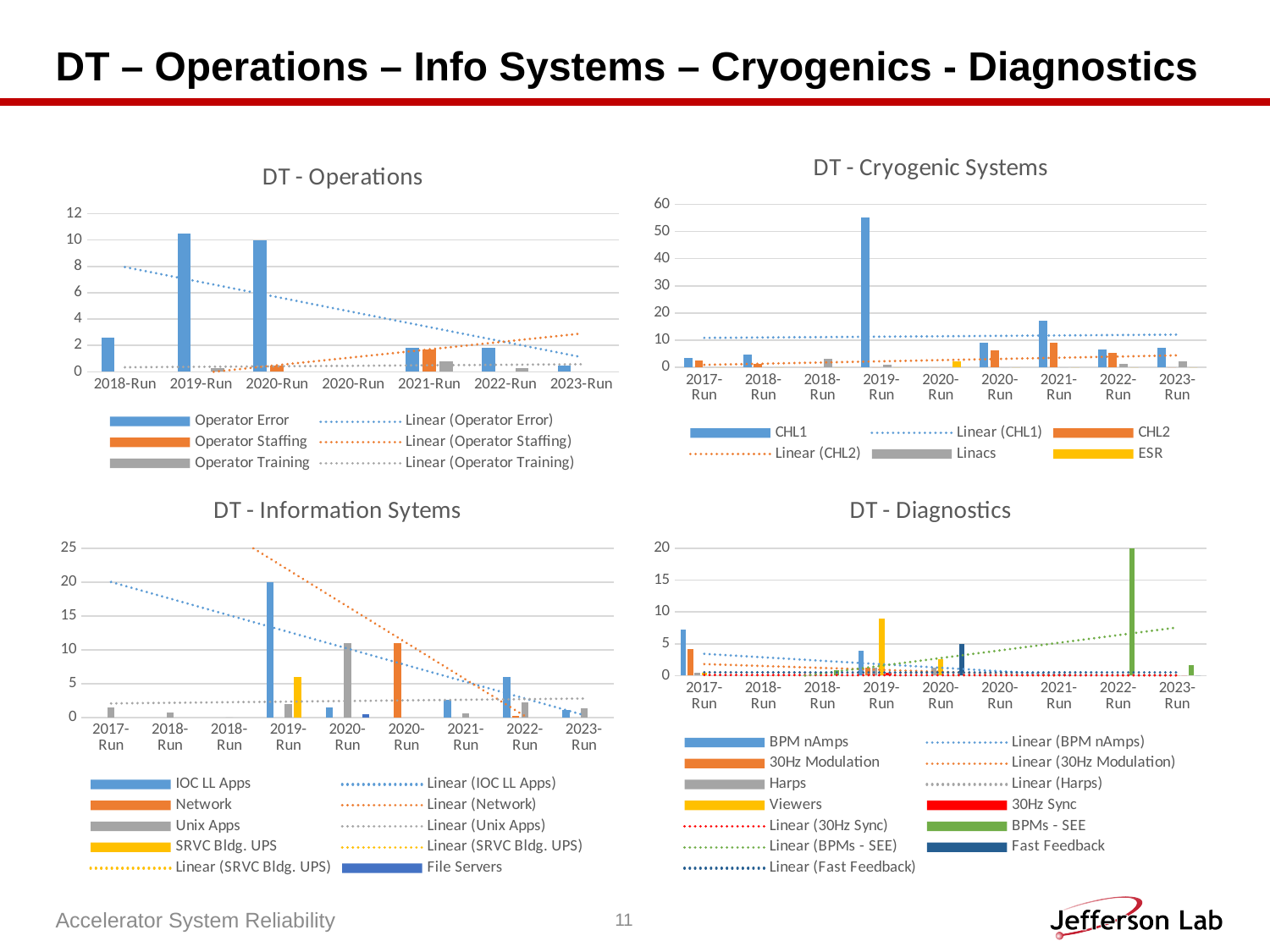
How many categories are shown on the x axis of the DT - Operations chart? 7 In the DT - Cryogenic Systems chart, which category has the highest CHL1 value? 2019-Run In the DT - Diagnostics chart, is the value for BPMs - SEE in 2022-Run greater or less than 15? greater In the DT - Operations chart, is the value for Operator Error in 2019-Run greater or less than 8? greater In the DT - Diagnostics chart, does the Linear (BPMs - SEE) trend line rise or fall from left to right? rise In the DT - Information Sytems chart, does the Linear (IOC LL Apps) trend line rise or fall from left to right? fall In the DT - Operations chart, does the Linear (Operator Error) trend line rise or fall from left to right? fall What kind of chart is DT - Diagnostics? bar chart How many entries does the legend of the DT - Cryogenic Systems chart list? 6 In the DT - Information Sytems chart, is the value for IOC LL Apps in 2019-Run greater or less than 15? greater In the DT - Information Sytems chart, which category has the highest IOC LL Apps value? 2019-Run